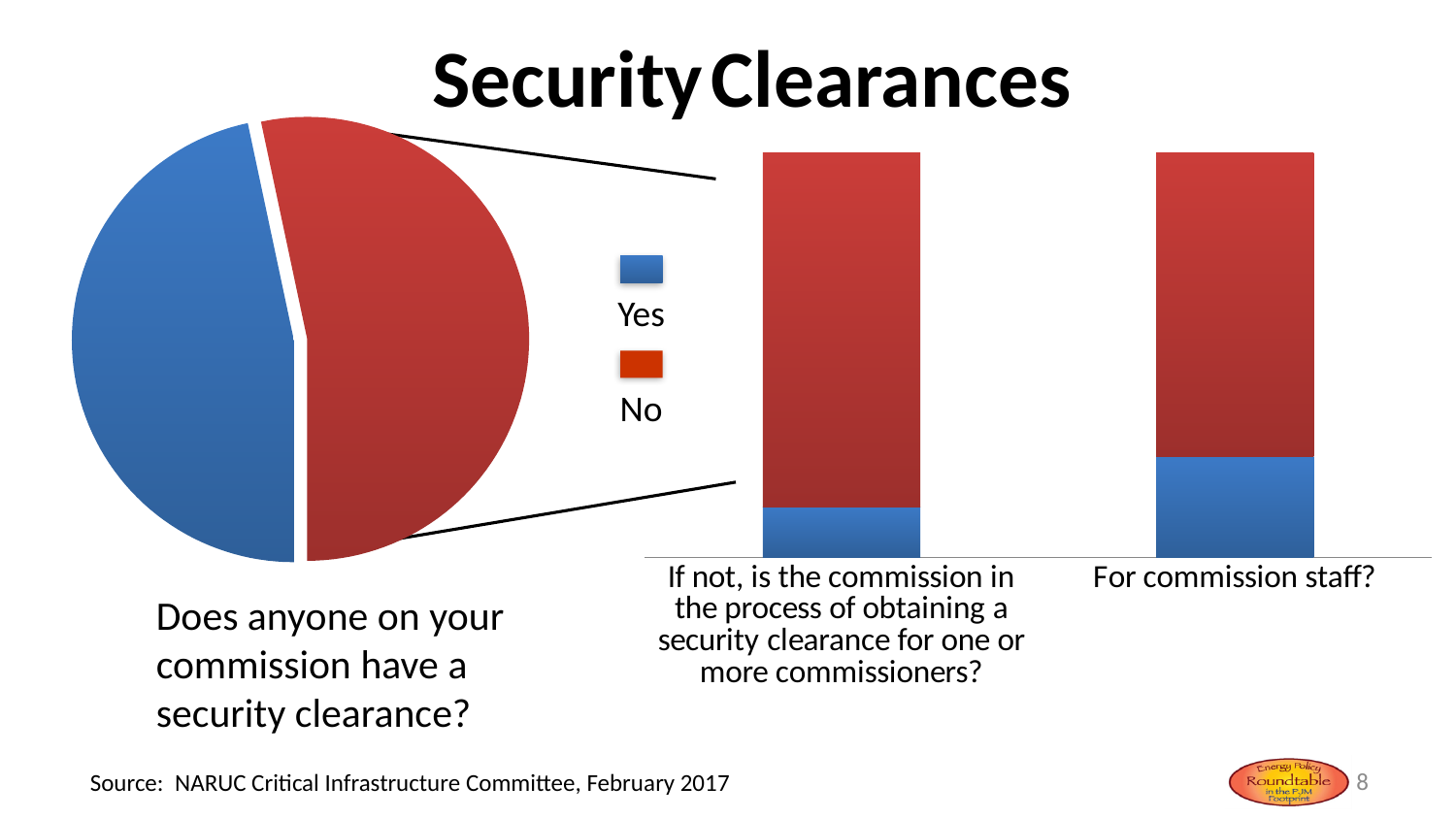
What is the title of the slide's charts? Security Clearances What kind of chart is on the right side of the slide? bar chart In the bar chart on the right, which category has the larger Yes portion? For commission staff? In the bar chart on the right, for the category 'If not, is the commission in the process of obtaining a security clearance for one or more commissioners?', which is larger, Yes or No? No Which colour represents 'Yes' in the charts? blue How many series does the legend list? 2 What kind of chart is on the left side of the slide? pie chart How many categories does the bar chart on the right show? 2 In the bar chart on the right, for the category 'For commission staff?', which is larger, Yes or No? No